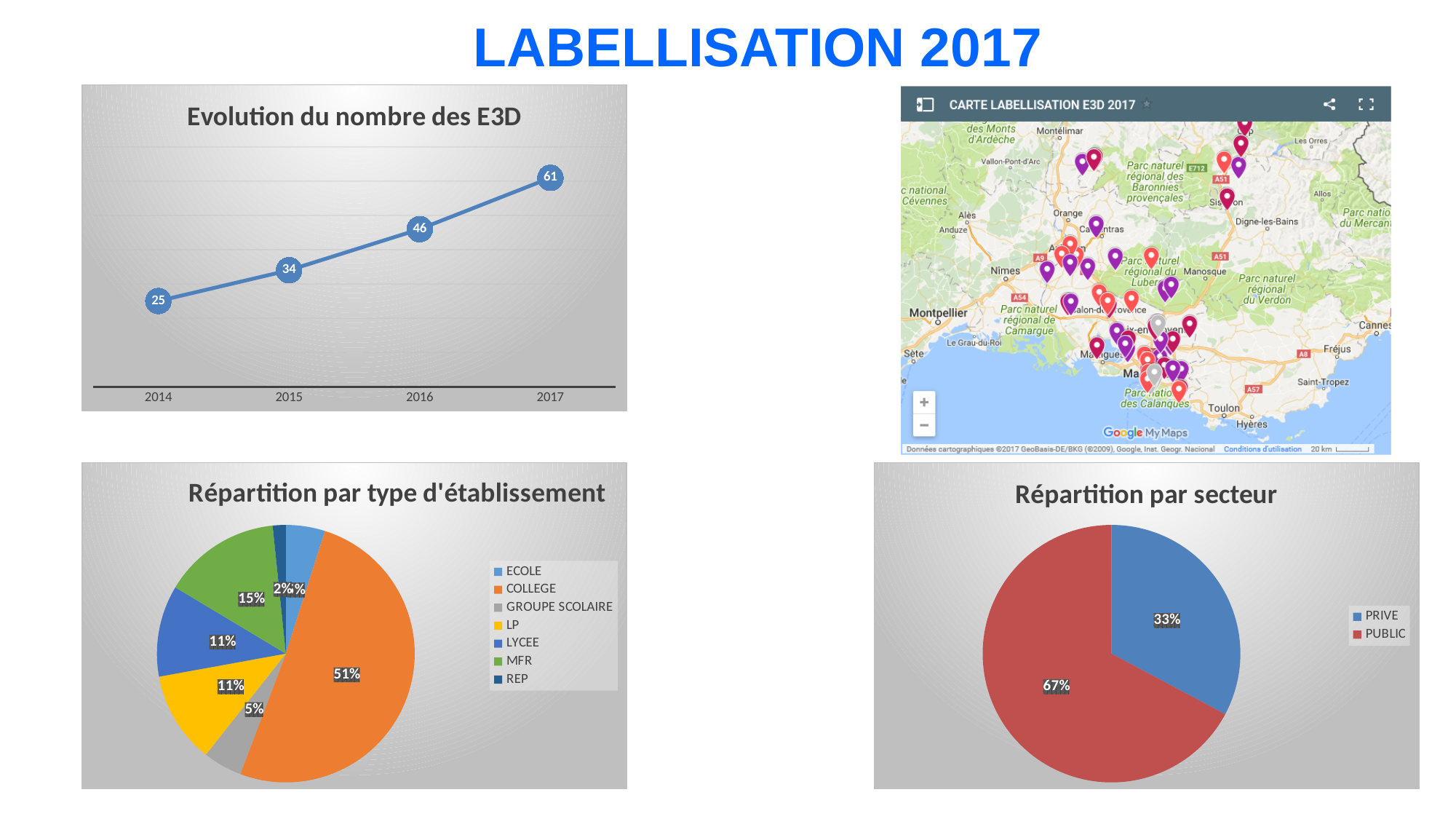
In the chart 'Evolution du nombre des E3D', what is the value for 2015? 34 In the chart 'Evolution du nombre des E3D', what is the difference between the values for 2017 and 2016? 15 In the chart 'Répartition par type d'établissement', which category has the largest share? COLLEGE In the chart 'Répartition par type d'établissement', what share does COLLEGE have? 51% What kind of chart is 'Evolution du nombre des E3D'? line chart In the chart 'Evolution du nombre des E3D', what is the value for 2017? 61 In the chart 'Evolution du nombre des E3D', what is the value for 2014? 25 In the chart 'Répartition par type d'établissement', what share does MFR have? 15% In the chart 'Evolution du nombre des E3D', do the values rise or fall from 2014 to 2017? rise In the chart 'Répartition par type d'établissement', how many categories does the legend list? 7 In the chart 'Evolution du nombre des E3D', how many years are plotted? 4 In the chart 'Répartition par secteur', what share does PUBLIC have? 67%